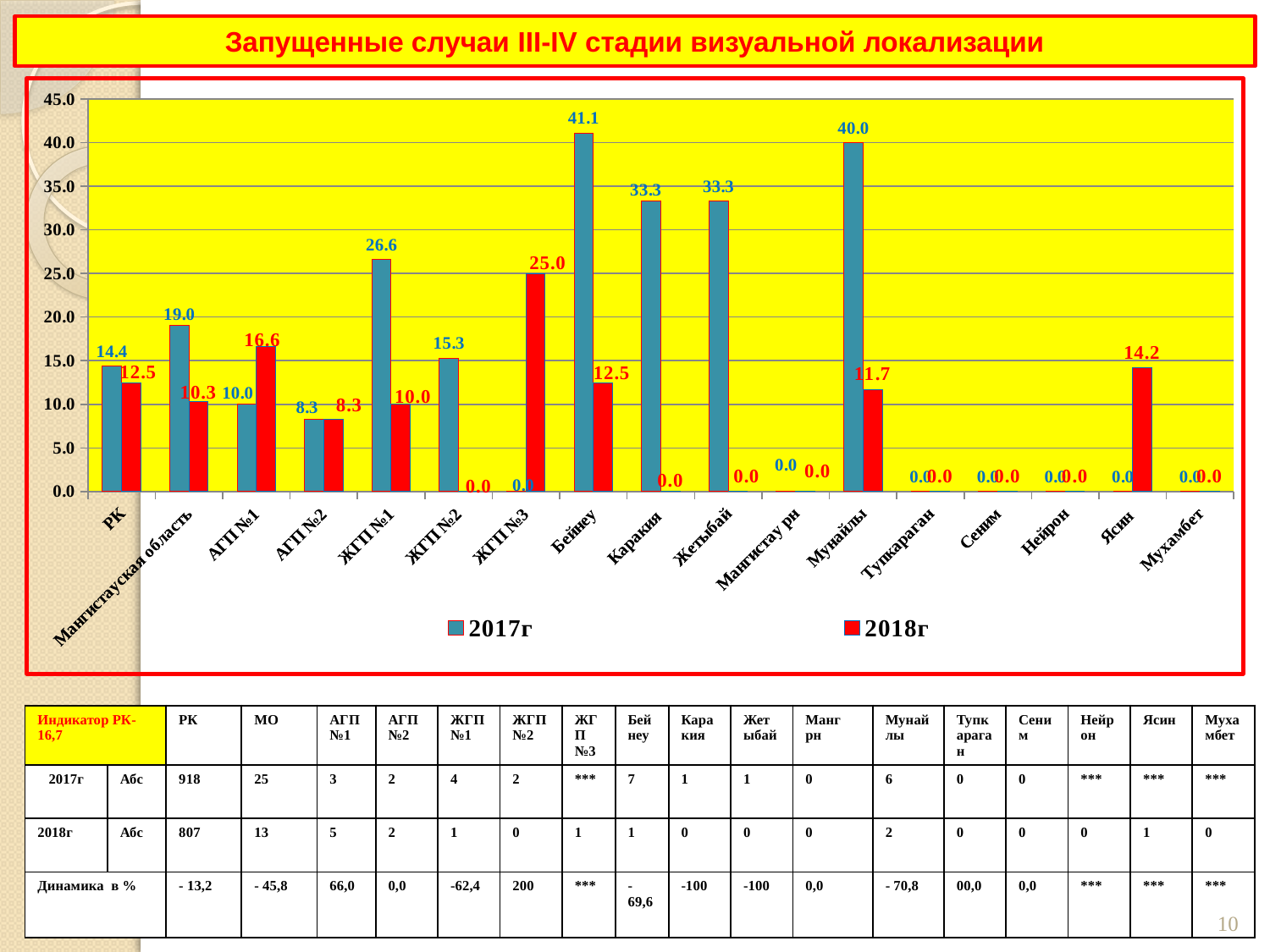
What kind of chart is shown on the slide? bar chart What is the 2017г value for Бейнеу? 41.1 Which category has the highest 2018г value? ЖГП №3 What is the difference between the 2017г and 2018г values for РК? 1.9 Which category has the highest 2017г value? Бейнеу What is the 2017г value for Мангистауская область? 19.0 What is the 2018г value for Мунайлы? 11.7 How many categories are shown on the x axis of the chart? 17 How many series does the legend list? 2 What is the difference between the 2017г and 2018г values for ЖГП №1? 16.6 What is the 2018г value for ЖГП №3? 25.0 Which is larger for АГП №1: the 2017г value or the 2018г value? 2018г